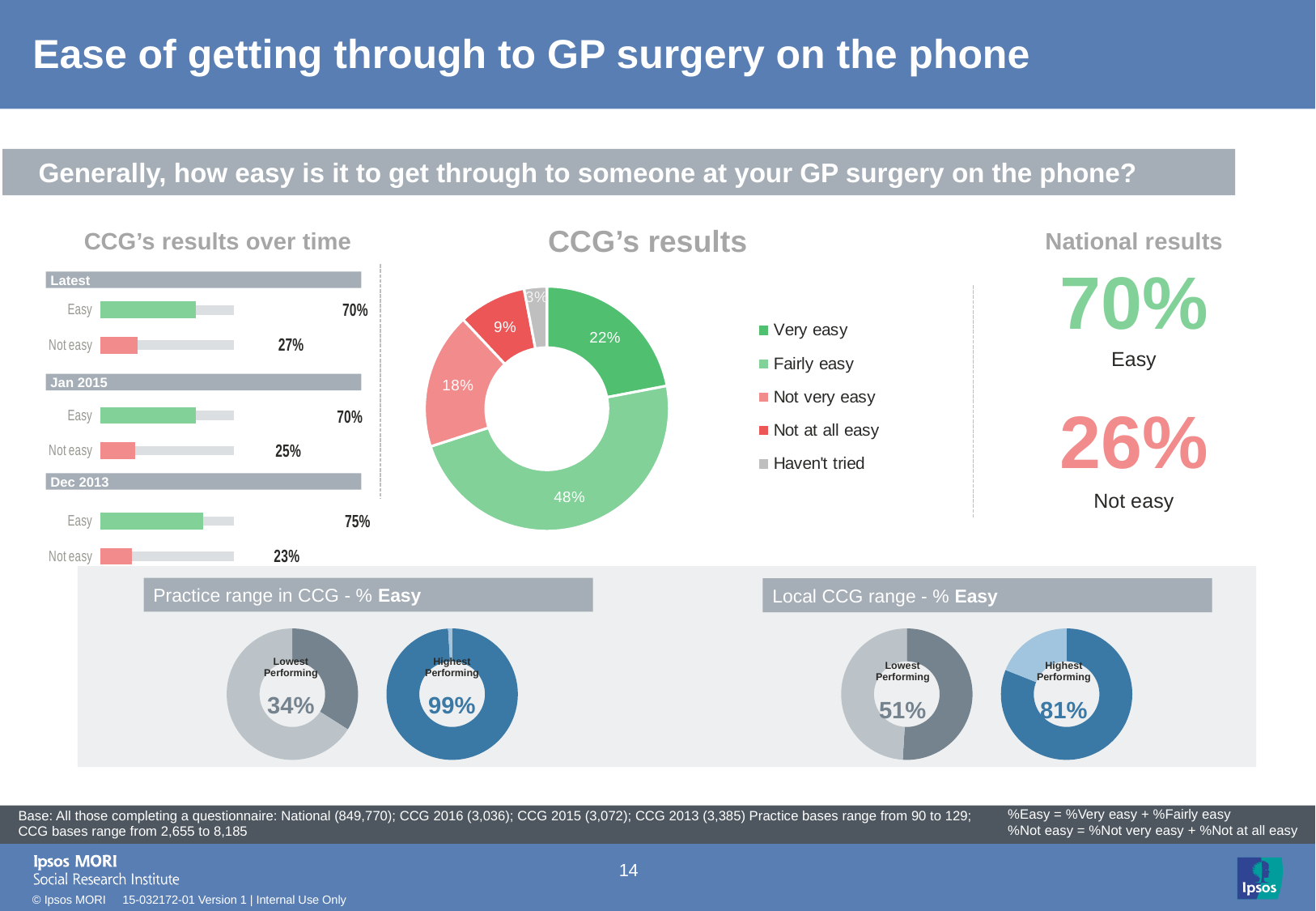
In the 'CCG's results' donut chart, what is the difference between the 'Very easy' and 'Not very easy' percentages? 4% In the 'CCG's results over time' chart, is the 'Not easy' value for Latest larger or smaller than for Dec 2013? Larger In the 'CCG's results over time' chart, what is the 'Easy' value for Dec 2013? 75% In the 'CCG's results' donut chart, which category has the smallest share? Haven't tried In the 'Practice range in CCG - % Easy' section, what is the value for the highest performing practice? 99% In the 'CCG's results' donut chart, what percentage is shown for 'Not at all easy'? 9% In the 'CCG's results over time' chart, what is the 'Not easy' value for Jan 2015? 25% In the 'CCG's results' donut chart, what percentage is shown for 'Fairly easy'? 48% In the 'CCG's results' donut chart, which category has the largest share? Fairly easy How many entries does the legend of the 'CCG's results' donut chart list? 5 In the 'Local CCG range - % Easy' section, what is the difference between the highest and lowest performing values? 30% What kind of chart is used for 'CCG's results'? Donut chart